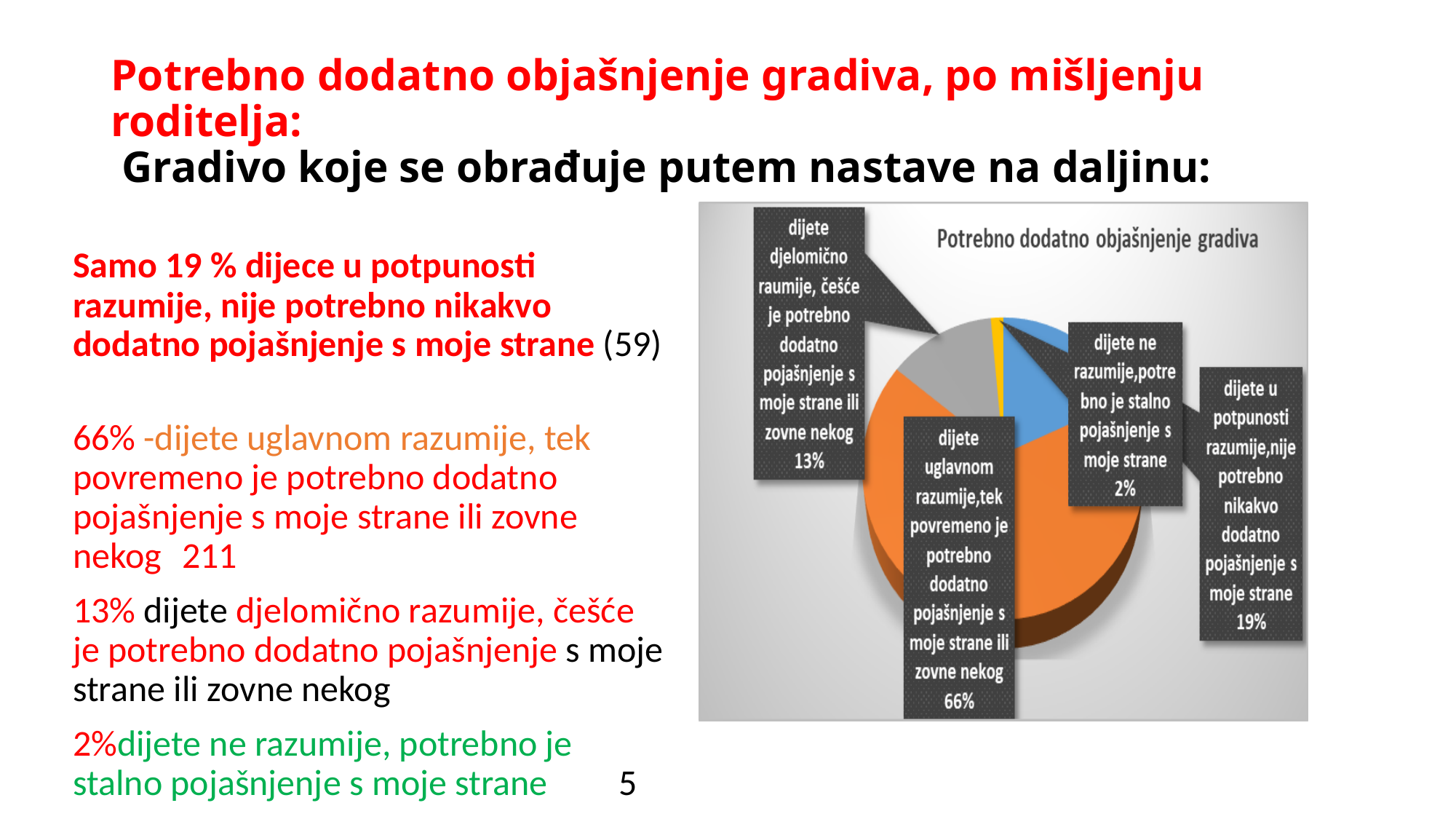
What share of the pie is labelled "dijete ne razumije, potrebno je stalno pojašnjenje s moje strane"? 2% What share of the pie is labelled "dijete u potpunosti razumije, nije potrebno nikakvo dodatno pojašnjenje s moje strane"? 19% How many slices does the pie chart have? 4 What colour is the largest slice of the pie chart? orange What is the difference in percentage points between the "dijete uglavnom razumije" slice and the "dijete u potpunosti razumije" slice? 47 What type of chart is shown on the slide? pie chart Which slice of the pie chart is the smallest? dijete ne razumije, potrebno je stalno pojašnjenje s moje strane Which slice of the pie chart is the largest? dijete uglavnom razumije, tek povremeno je potrebno dodatno pojašnjenje s moje strane ili zovne nekog What share of the pie is labelled "dijete djelomično razumije, češće je potrebno dodatno pojašnjenje s moje strane ili zovne nekog"? 13% Which is larger: the "dijete u potpunosti razumije" slice or the "dijete djelomično razumije" slice? dijete u potpunosti razumije What is the title of the chart? Potrebno dodatno objašnjenje gradiva